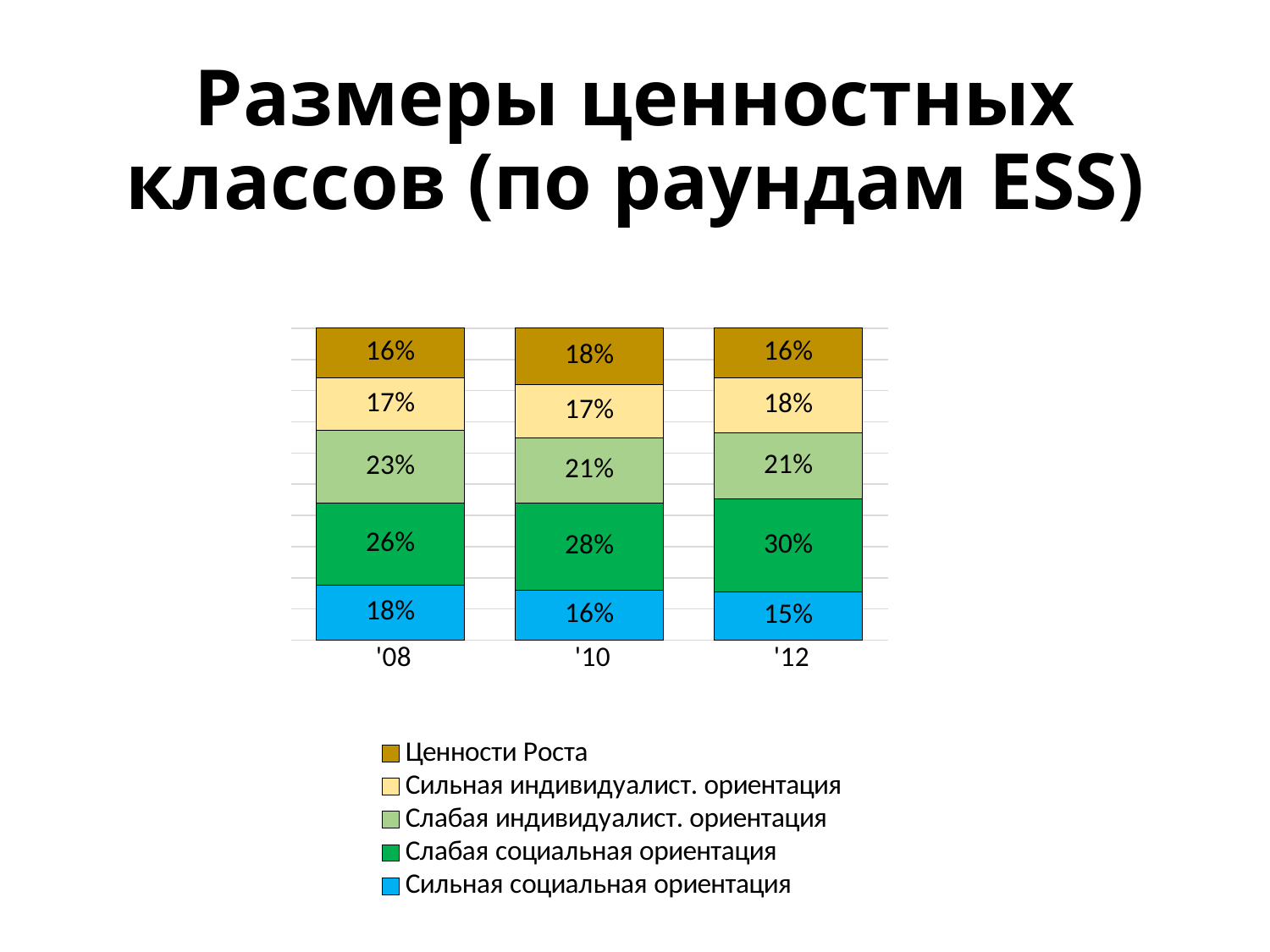
How many categories (ESS rounds) are shown on the x axis? 3 In which round is Слабая социальная ориентация highest? '12 How many series does the legend list? 5 Does Слабая социальная ориентация rise or fall from '08 to '12? rise What kind of chart is shown on the slide? stacked bar chart In which round is Сильная социальная ориентация lowest? '12 What is the difference between Слабая социальная ориентация in '12 and in '08? 4% Which is larger: Сильная индивидуалист. ориентация in '12 or Ценности Роста in '12? Сильная индивидуалист. ориентация What is the value for Слабая социальная ориентация in '12? 30% What is the value for Сильная социальная ориентация in '08? 18% What is the value for Ценности Роста in '10? 18% What is the value for Слабая индивидуалист. ориентация in '08? 23%